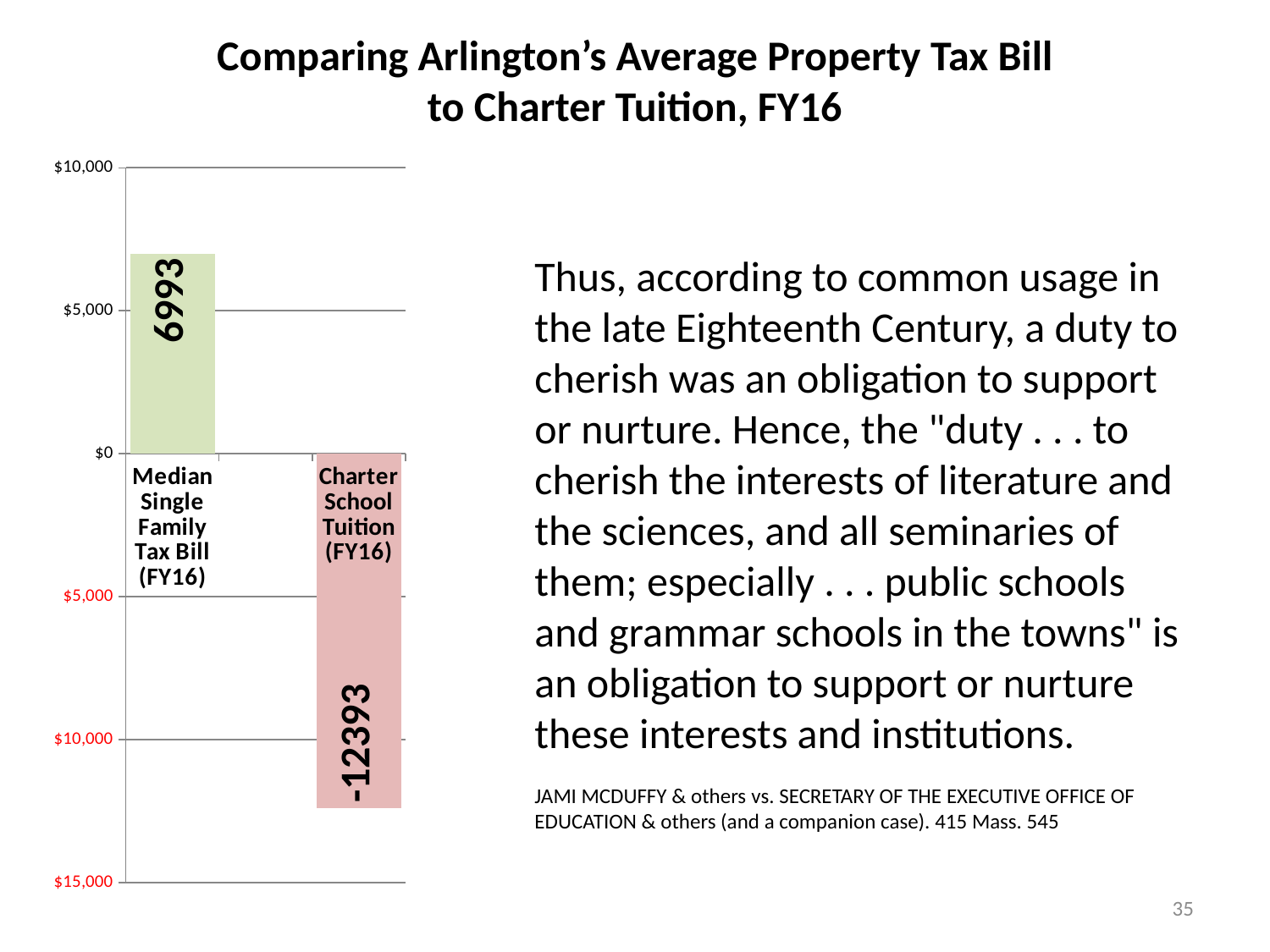
What is the title of the chart? Comparing Arlington's Average Property Tax Bill to Charter Tuition, FY16 Which category has the highest value? Median Single Family Tax Bill (FY16) What is the value for Charter School Tuition (FY16)? -12393 How many categories are plotted in the chart? 2 Which is larger, the value for Median Single Family Tax Bill (FY16) or the value for Charter School Tuition (FY16)? Median Single Family Tax Bill (FY16) By how much does the value for Median Single Family Tax Bill (FY16) exceed the value for Charter School Tuition (FY16)? 19386 Is the value for Median Single Family Tax Bill (FY16) greater or less than $5,000? greater Which category's bar extends below the $0 line? Charter School Tuition (FY16) Is the value for Charter School Tuition (FY16) greater or less than -$10,000? less What is the value for Median Single Family Tax Bill (FY16)? 6993 What kind of chart is shown on the slide? Bar chart Which category has the lowest value? Charter School Tuition (FY16)